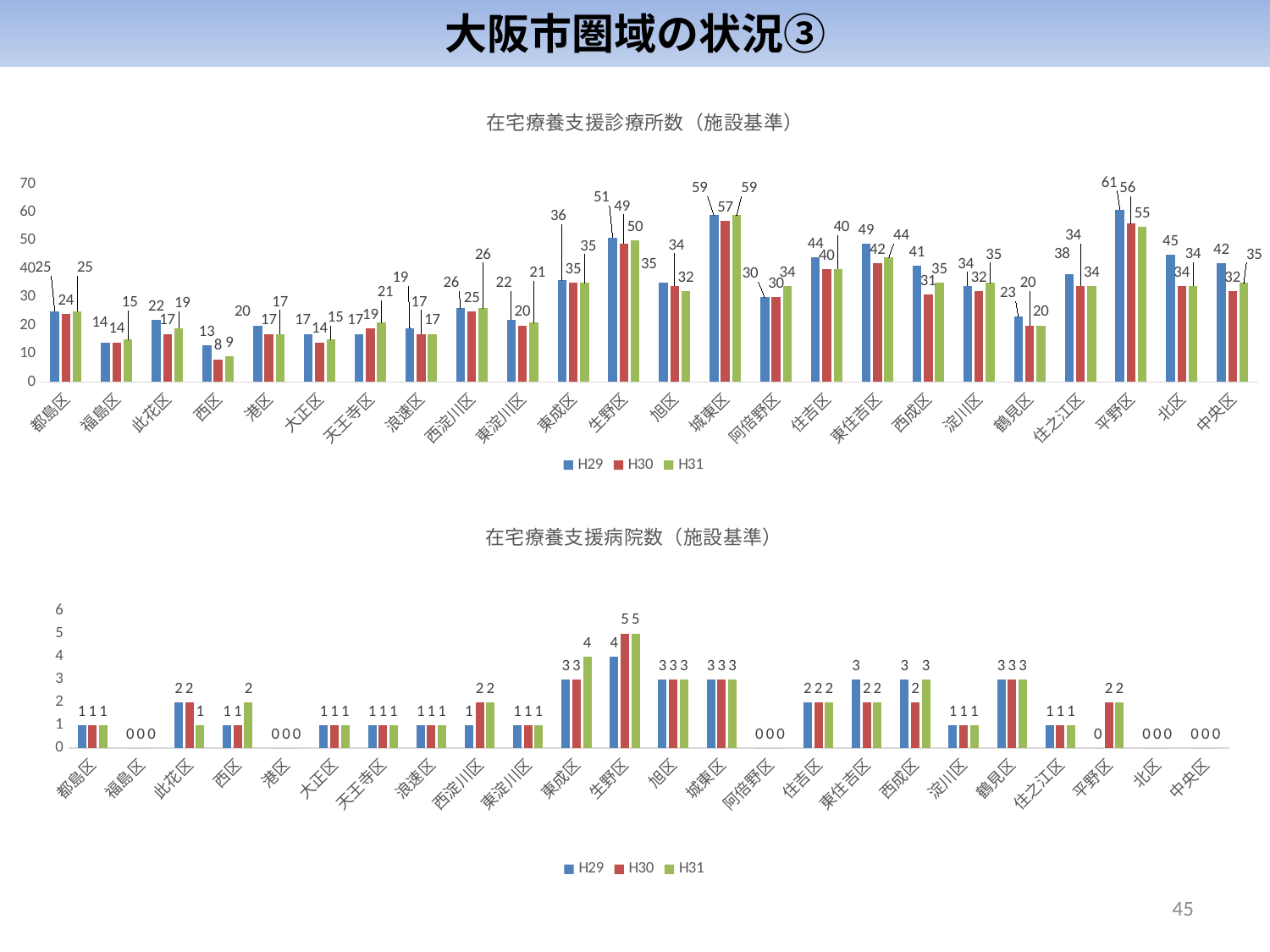
In the chart titled 在宅療養支援診療所数（施設基準）, which ward has the lowest H30 value? 西区 In the chart titled 在宅療養支援診療所数（施設基準）, which ward has the highest H29 value? 平野区 In the chart titled 在宅療養支援診療所数（施設基準）, what is the H31 value for 阿倍野区? 34 In the chart titled 在宅療養支援診療所数（施設基準）, what is the difference between the H29 and H31 values for 北区? 11 In the chart titled 在宅療養支援診療所数（施設基準）, what is the H29 value for 生野区? 51 In the chart titled 在宅療養支援病院数（施設基準）, what is the H31 value for 東成区? 4 What kind of chart is the chart titled 在宅療養支援診療所数（施設基準）? Bar chart In the chart titled 在宅療養支援診療所数（施設基準）, how many wards are shown on the x axis? 24 In the chart titled 在宅療養支援病院数（施設基準）, what is the H30 value for 生野区? 5 How many series does the legend of the chart titled 在宅療養支援病院数（施設基準） list? 3 In the chart titled 在宅療養支援病院数（施設基準）, what is the difference between the H31 and H29 values for 平野区? 2 In the chart titled 在宅療養支援診療所数（施設基準）, which is larger for 西成区: the H29 value or the H30 value? H29